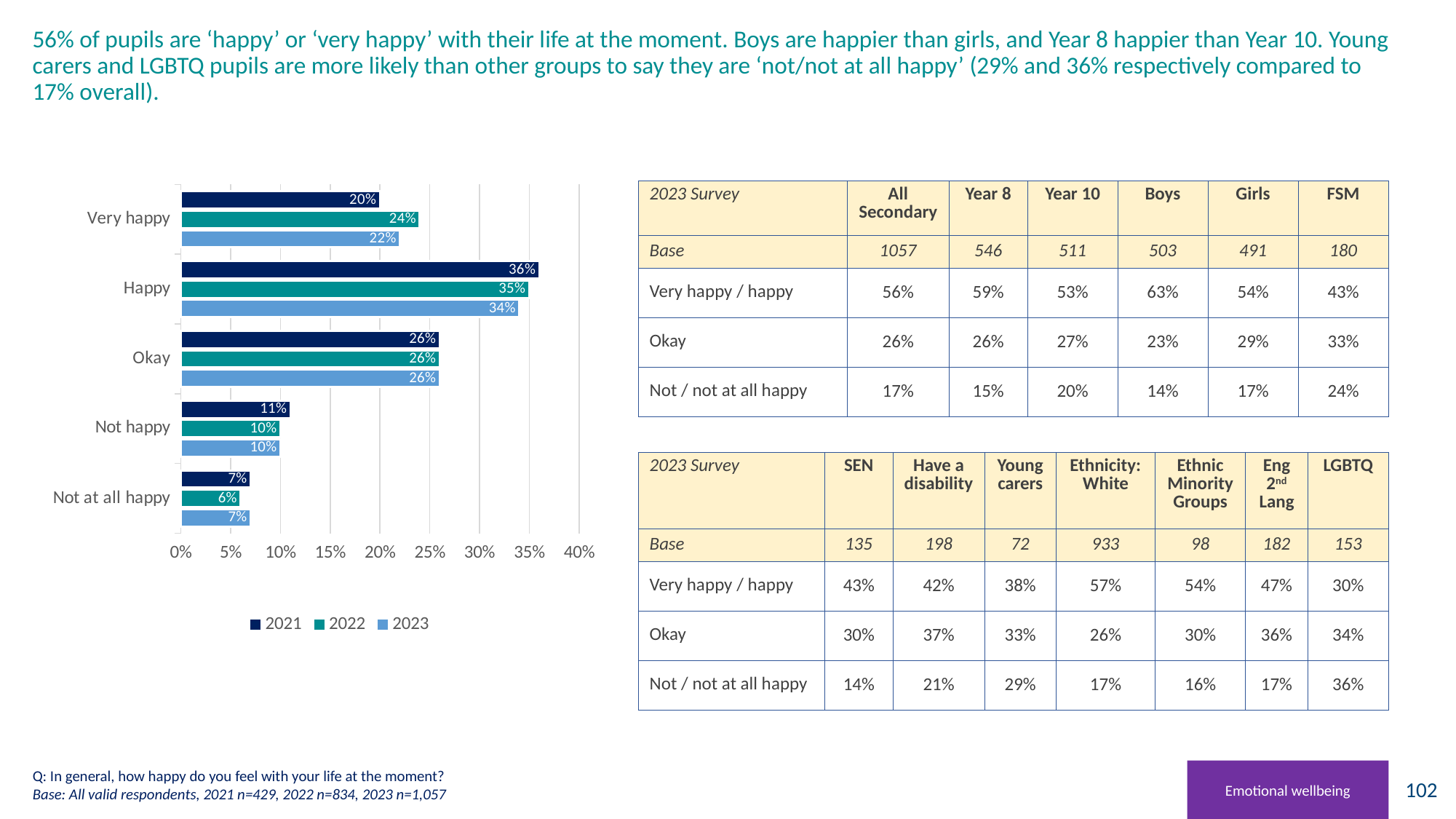
Which category has the lowest value for the 2022 series? Not at all happy Which is larger: the 2021 value for 'Not happy' or the 2023 value for 'Not happy'? 2021 What is the difference between the 2021 and 2023 values for 'Very happy'? 2% What percentage of pupils said they were 'Not at all happy' in 2021? 7% What percentage of pupils said they were 'Very happy' in 2022? 24% Which years are listed in the chart legend? 2021, 2022, 2023 How many response categories are shown on the chart? 5 What is the 2023 value for 'Happy'? 34% What type of chart is shown on the slide? Bar chart How many series does the chart legend list? 3 Which category has the highest value for the 2021 series? Happy What is the 'Okay' value for 2023? 26%